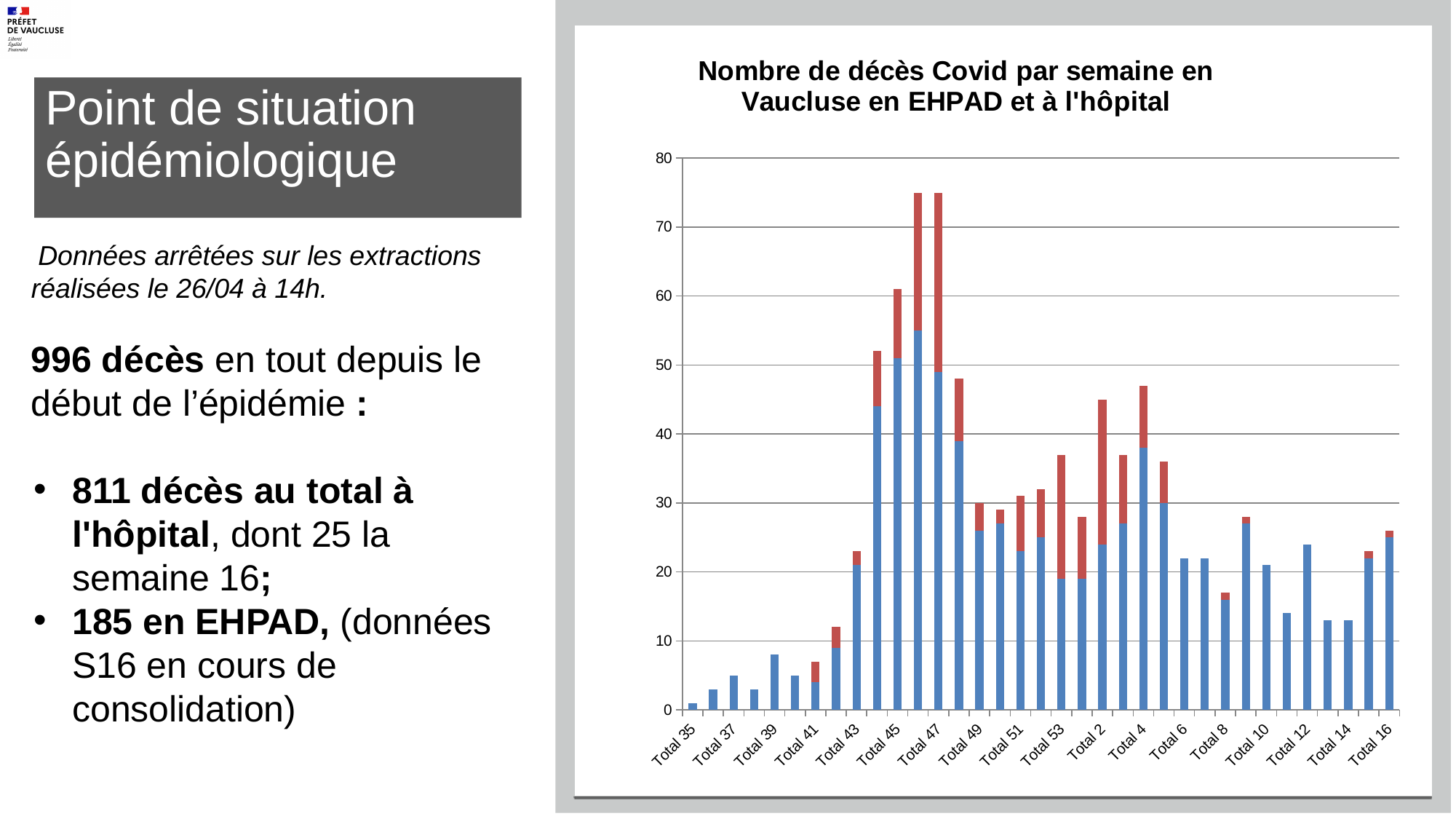
Is the value for Total 43 greater or less than 30? less What kind of chart is shown on the slide? Bar chart Which labeled week has the lowest bar in the chart? Total 35 How many colours are used for the bar segments in the chart? 2 Which is larger, the bar for Total 43 or the bar for Total 45? Total 45 Is the value for Total 4 greater or less than 40? greater Do the values generally rise or fall from Total 35 to Total 47? rise Is the value for Total 47 greater or less than 70? greater What is the title of the chart? Nombre de décès Covid par semaine en Vaucluse en EHPAD et à l'hôpital Which is larger, the bar for Total 47 or the bar for Total 49? Total 47